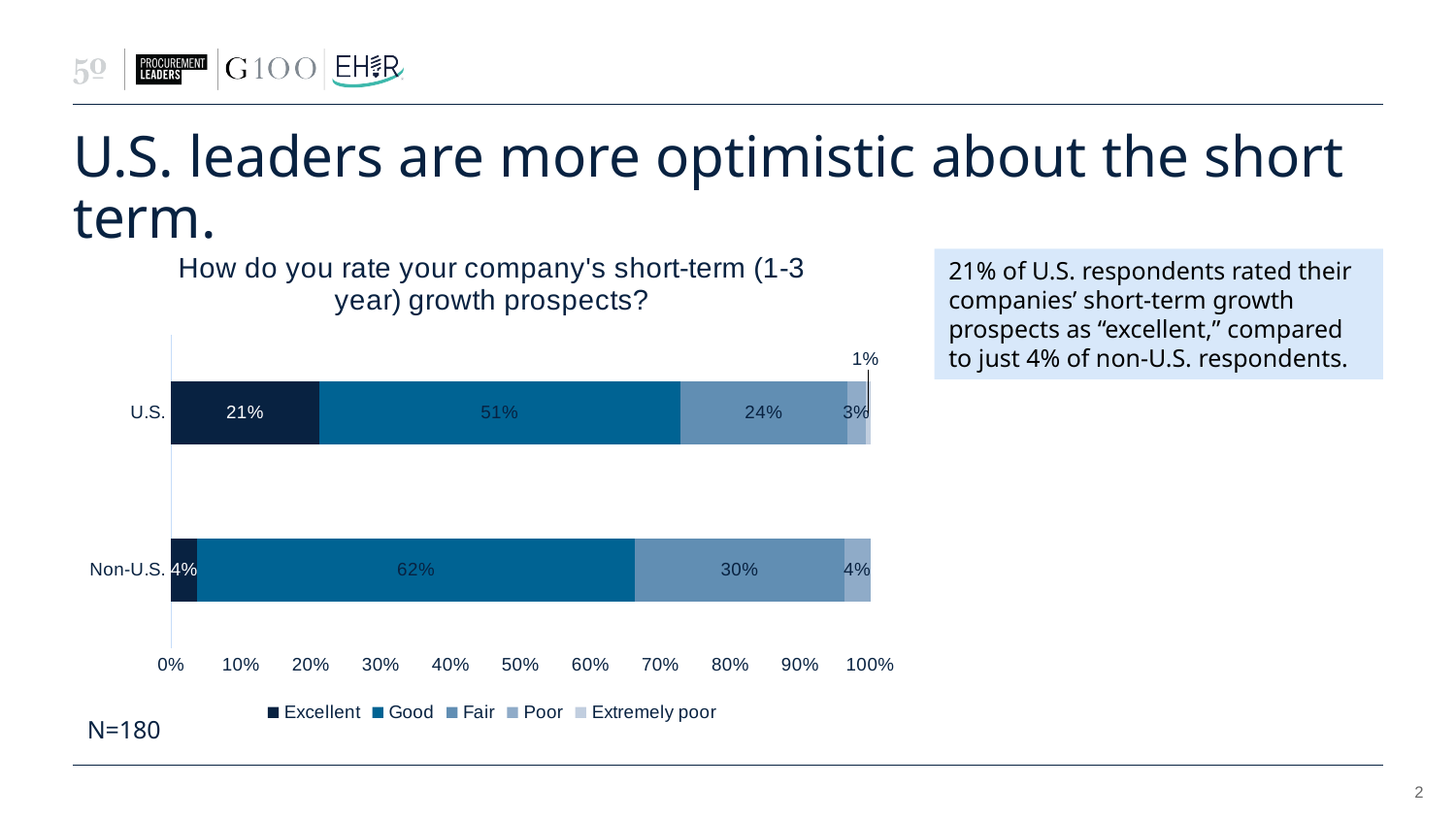
What type of chart is shown on the slide? Stacked bar chart What percentage of U.S. respondents rated their short-term growth prospects as "Excellent"? 21% What is the "Fair" value for the Non-U.S. bar? 30% What is the "Poor" value for the U.S. bar? 3% How many respondent groups (categories) are shown on the chart? 2 Which group has the larger "Good" share, U.S. or Non-U.S.? Non-U.S. What is the difference between the "Excellent" values for U.S. and Non-U.S. respondents? 17 percentage points What percentage of Non-U.S. respondents rated their short-term growth prospects as "Good"? 62% What is the title of the chart? How do you rate your company's short-term (1-3 year) growth prospects? Which group has the larger "Fair" share, U.S. or Non-U.S.? Non-U.S. How many series does the legend list? 5 What is the "Extremely poor" value for the U.S. bar? 1%